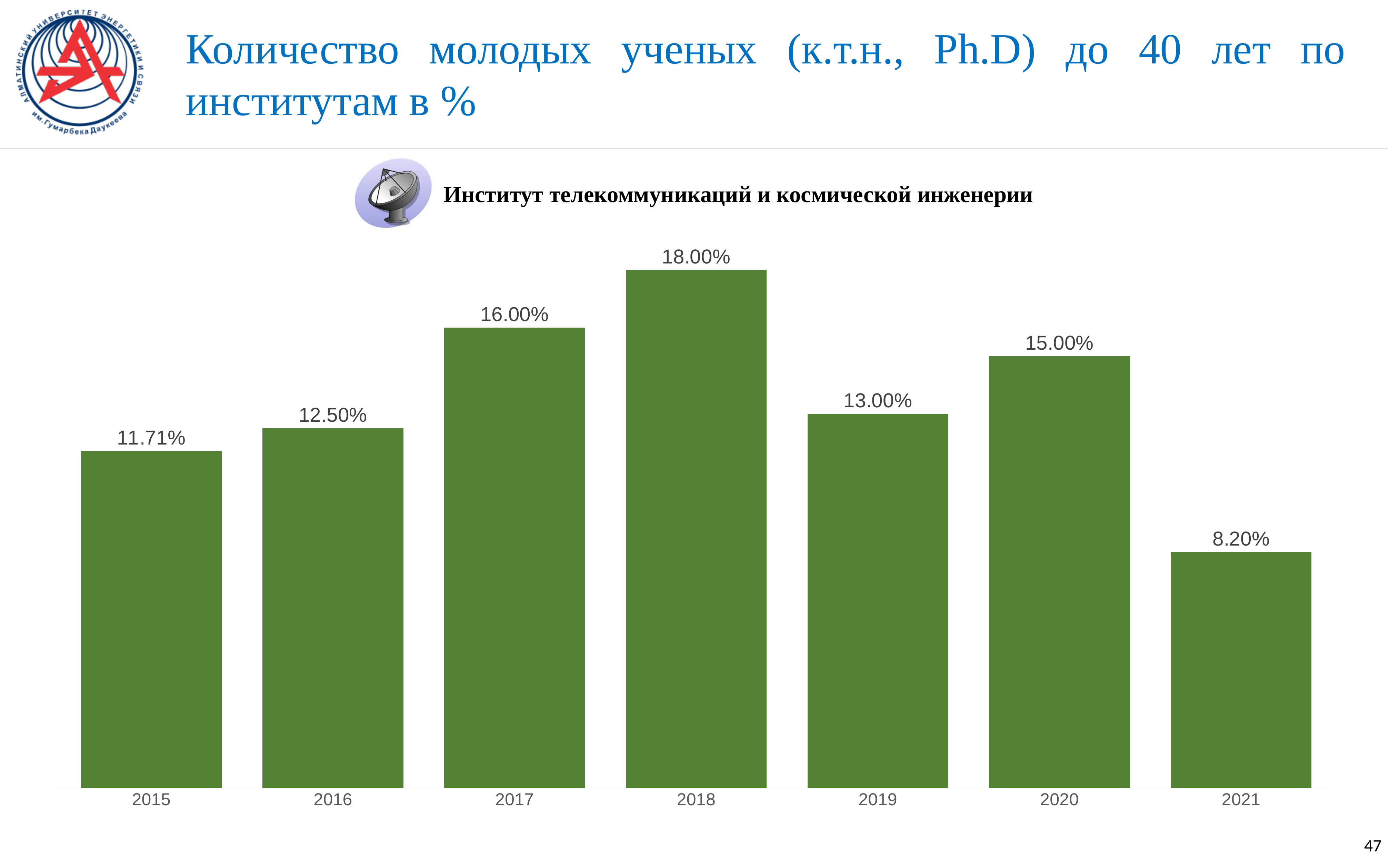
What kind of chart is shown on the slide? bar chart What is the value for 2018? 18.00% What is the difference between the values for 2016 and 2015? 0.79% Which is larger, the value for 2017 or the value for 2020? 2017 What is the value for 2015? 11.71% How many years are shown on the x axis? 7 What is the value for 2021? 8.20% Which institute does the chart refer to? Институт телекоммуникаций и космической инженерии Which year has the highest value? 2018 Do the values rise or fall from 2018 to 2019? fall Which year has the lowest value? 2021 What is the difference between the values for 2018 and 2019? 5.00%